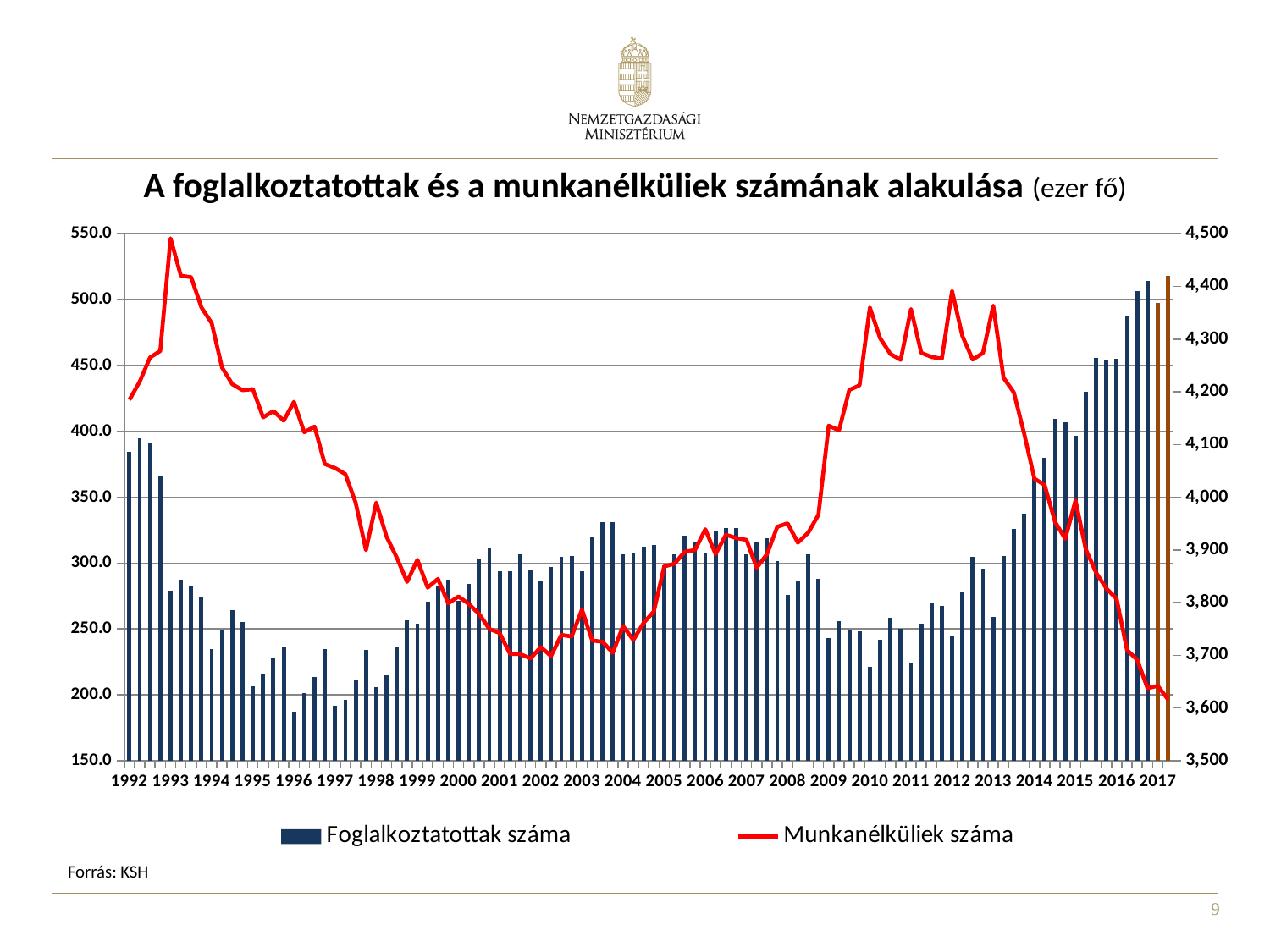
In which year does the Munkanélküliek száma line reach its highest point? 1993 Does the Munkanélküliek száma line rise or fall between 2013 and 2017? fall How many years are labelled on the x axis? 26 In which year does the Munkanélküliek száma line reach its lowest point? 2017 How many series does the legend list? 2 Is the Munkanélküliek száma value at the end of 2017 greater or less than 250? less Is the peak value of the Munkanélküliek száma line in 1993 greater or less than 500? greater Which series is drawn as a red line? Munkanélküliek száma In which year is the tallest Foglalkoztatottak száma bar? 2017 What kind of chart is shown on the slide? A combined bar and line chart What is the title of the chart? A foglalkoztatottak és a munkanélküliek számának alakulása (ezer fő)